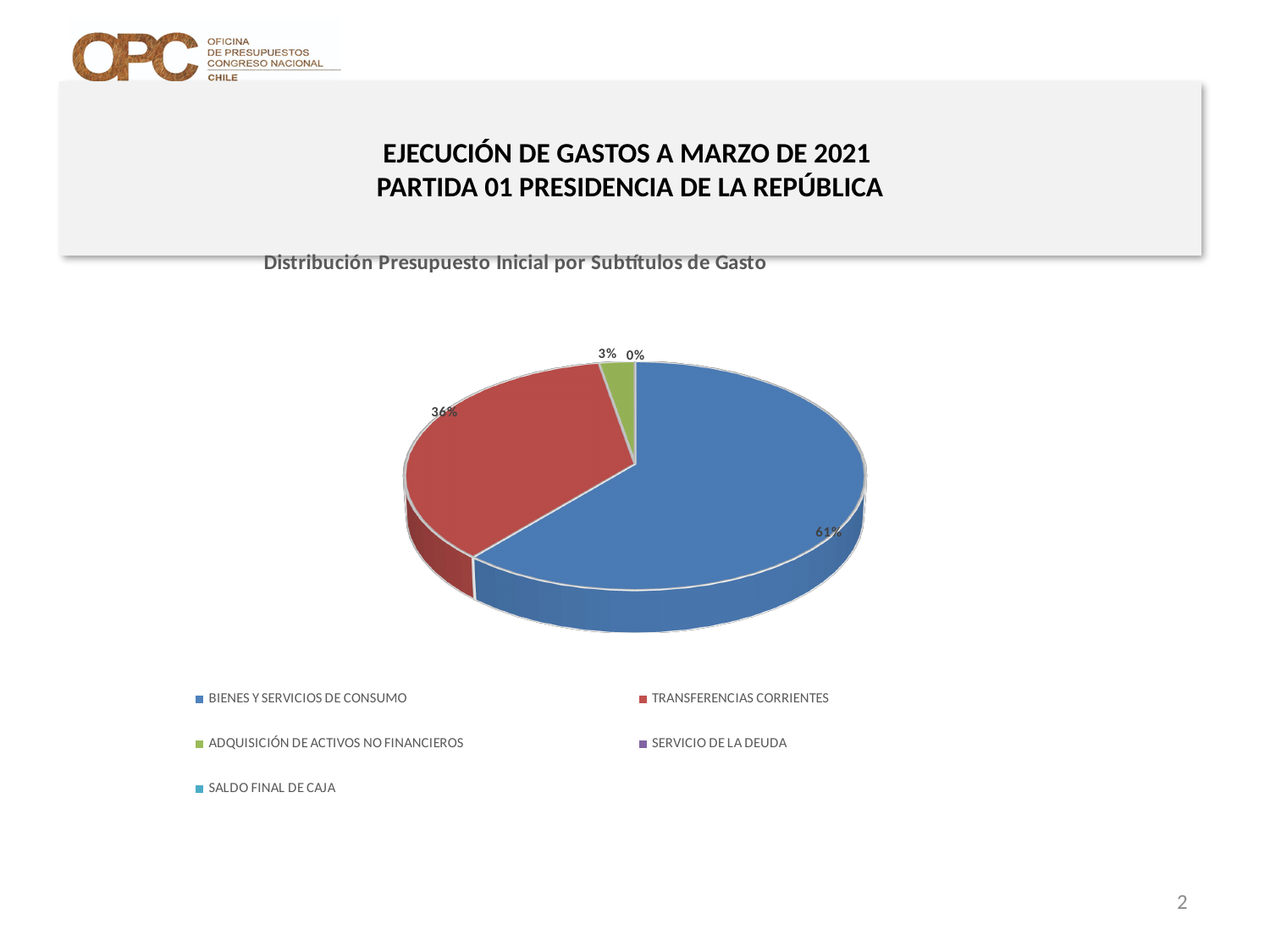
Which category has the largest slice of the pie? BIENES Y SERVICIOS DE CONSUMO By how many percentage points does BIENES Y SERVICIOS DE CONSUMO exceed TRANSFERENCIAS CORRIENTES? 25 percentage points What share of the pie does BIENES Y SERVICIOS DE CONSUMO represent? 61% What is the title of the chart? Distribución Presupuesto Inicial por Subtítulos de Gasto What percentage is shown for TRANSFERENCIAS CORRIENTES? 36% What kind of chart is shown on the slide? Pie chart By how many percentage points does TRANSFERENCIAS CORRIENTES exceed ADQUISICIÓN DE ACTIVOS NO FINANCIEROS? 33 percentage points Is the share for BIENES Y SERVICIOS DE CONSUMO greater or less than 50%? greater What colour is the slice for TRANSFERENCIAS CORRIENTES? Red How many categories does the legend list? 5 What percentage is shown for ADQUISICIÓN DE ACTIVOS NO FINANCIEROS? 3% Which is larger, the slice for TRANSFERENCIAS CORRIENTES or the slice for ADQUISICIÓN DE ACTIVOS NO FINANCIEROS? TRANSFERENCIAS CORRIENTES